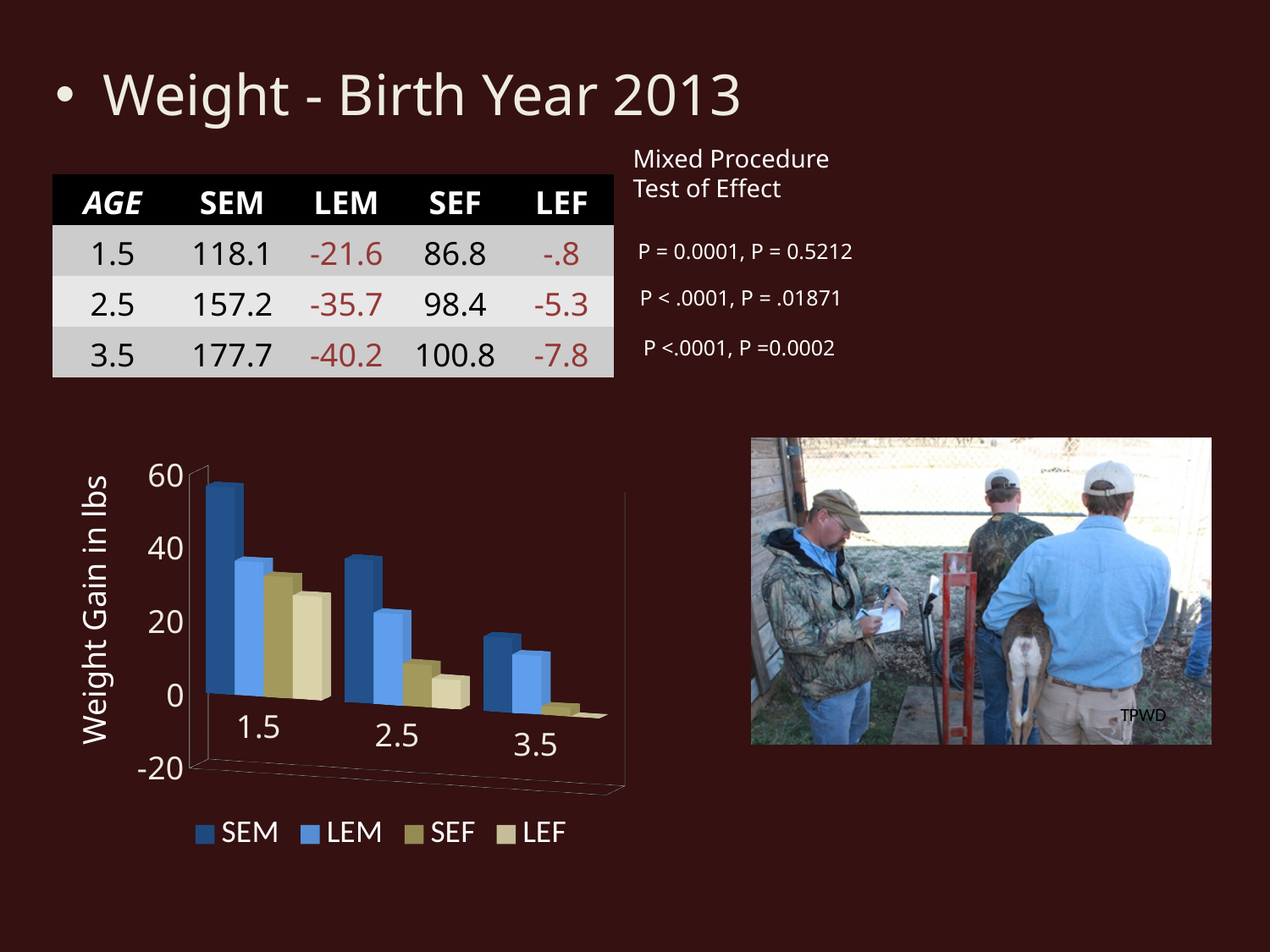
How many age categories are shown on the x axis of the chart? 3 Is the value for LEM at age 2.5 greater or less than 40? less Which series has the highest bar at age 1.5? SEM Which is larger, the SEM bar at age 1.5 or the SEM bar at age 3.5? SEM at age 1.5 How many series does the chart legend list? 4 What is the label of the vertical axis of the chart? Weight Gain in lbs Do the SEM values rise or fall as age increases from 1.5 to 3.5? fall At which age is the SEM bar the tallest? 1.5 Is the value for SEM at age 2.5 greater or less than 20? greater Which series has the lowest bar at age 2.5? LEF Is the value for SEM at age 1.5 greater or less than 40? greater What kind of chart is shown on the slide? bar chart